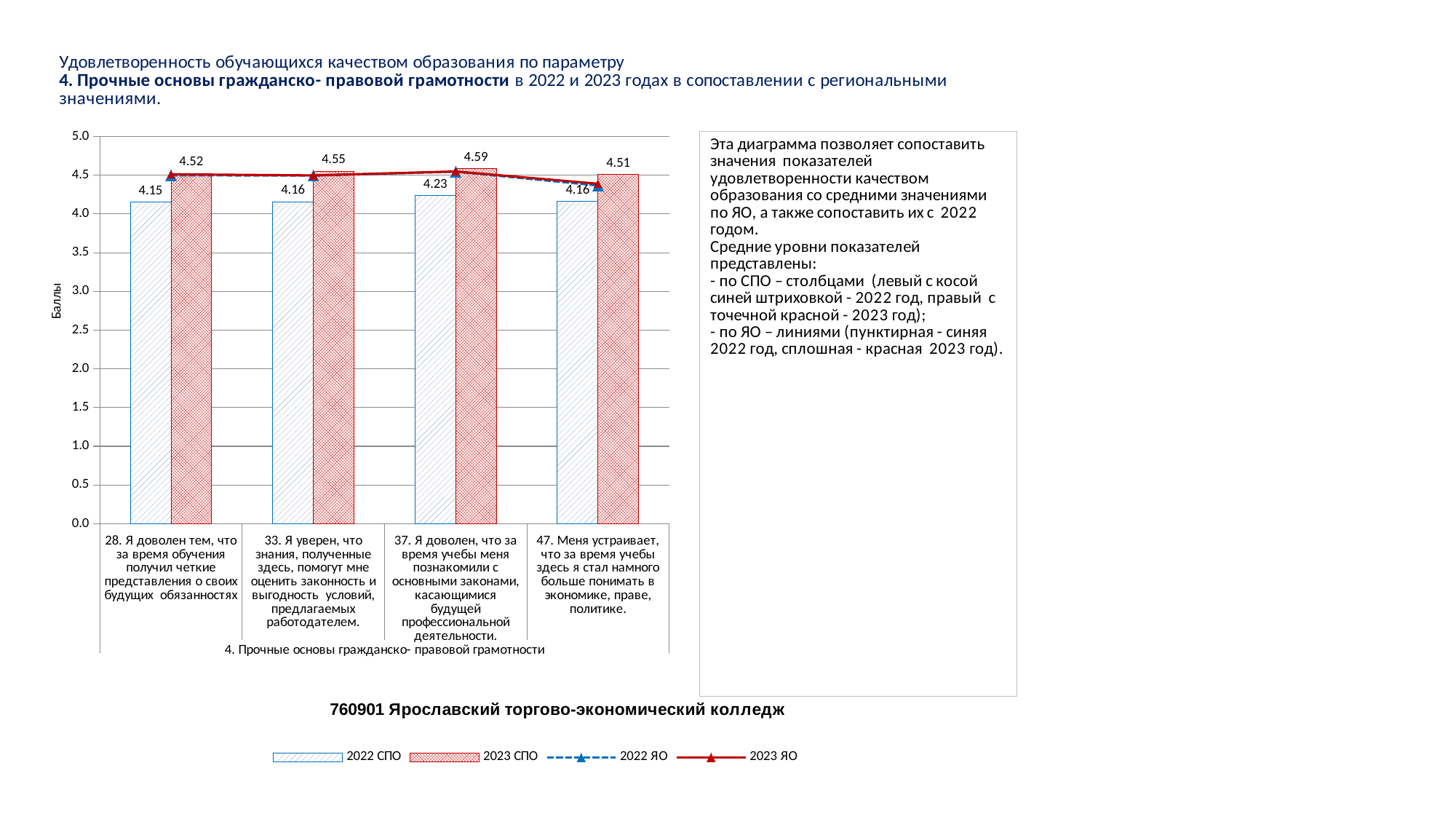
Which item has the highest 2022 СПО value? 37. Я доволен, что за время учебы меня познакомили с основными законами, касающимися будущей профессиональной деятельности. What is the label of the vertical axis? Баллы What is the difference between the 2023 СПО and 2022 СПО values for item 33? 0.39 Which is larger for item 28: the 2022 СПО value or the 2023 СПО value? 2023 СПО How many survey items (categories) are shown on the x axis? 4 What is the 2023 СПО value for item 47 (Меня устраивает, что за время учебы здесь я стал намного больше понимать в экономике, праве, политике)? 4.51 How many series does the legend list? 4 Is the 2022 ЯО line value for item 37 greater or less than 4.0? greater What is the 2022 СПО value for item 28 (Я доволен тем, что за время обучения получил четкие представления о своих будущих обязанностях)? 4.15 Which item has the lowest 2023 СПО value? 47. Меня устраивает, что за время учебы здесь я стал намного больше понимать в экономике, праве, политике. What kind of chart is shown on the slide? Combined bar and line chart What is the 2023 СПО value for item 37 (Я доволен, что за время учебы меня познакомили с основными законами...)? 4.59